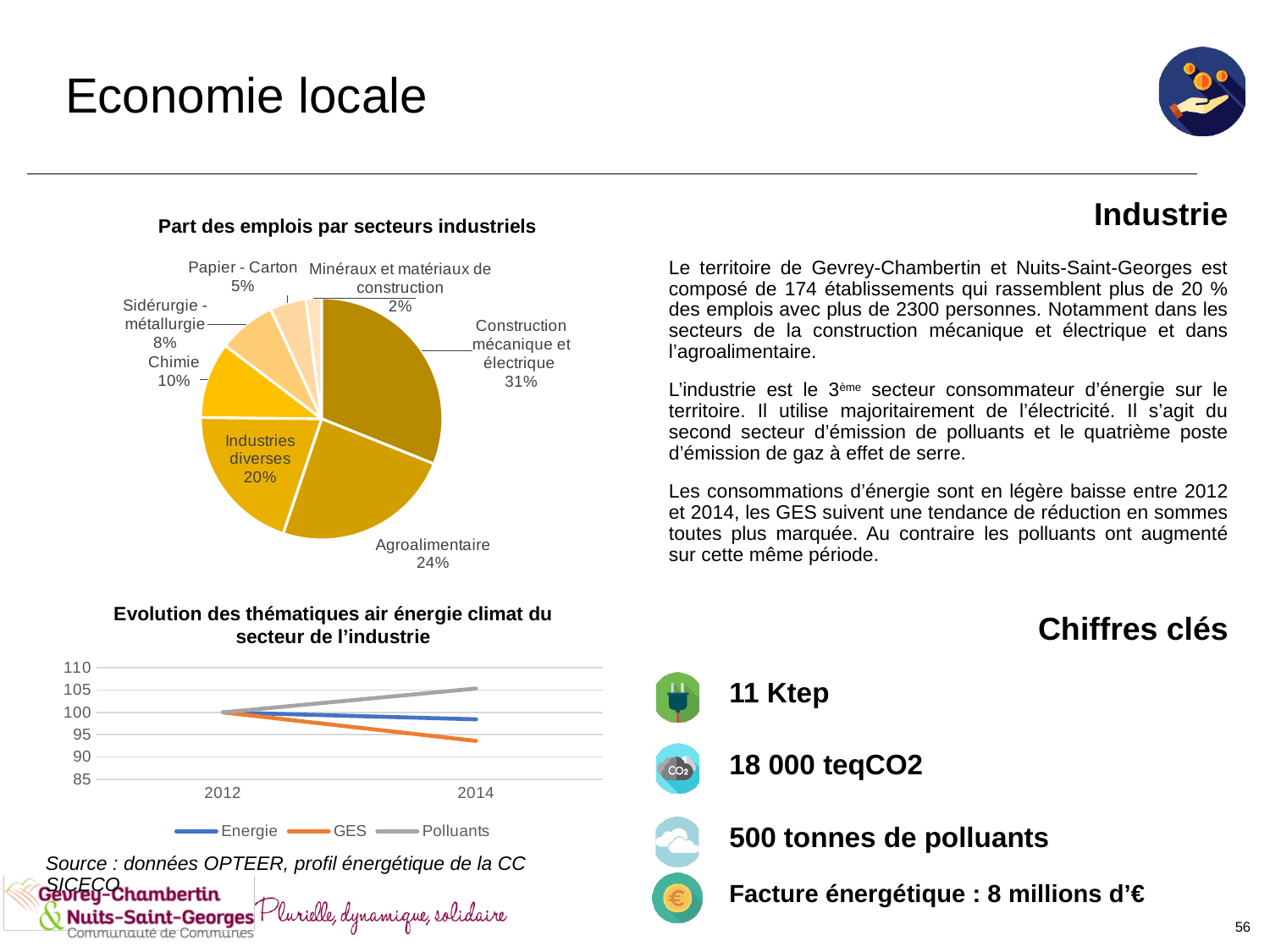
In the pie chart 'Part des emplois par secteurs industriels', which sector has the largest share? Construction mécanique et électrique In the chart 'Evolution des thématiques air énergie climat du secteur de l'industrie', is the value for GES in 2014 greater or less than 100? less In the pie chart 'Part des emplois par secteurs industriels', which sector has the smallest share? Minéraux et matériaux de construction In the pie chart 'Part des emplois par secteurs industriels', which is larger: Sidérurgie - métallurgie or Papier - Carton? Sidérurgie - métallurgie How many sectors are shown in the pie chart 'Part des emplois par secteurs industriels'? 7 What type of chart is 'Evolution des thématiques air énergie climat du secteur de l'industrie'? Line chart In the pie chart 'Part des emplois par secteurs industriels', what is the difference in percentage points between Industries diverses and Chimie? 10 How many series does the legend of the chart 'Evolution des thématiques air énergie climat du secteur de l'industrie' list? 3 In the pie chart 'Part des emplois par secteurs industriels', what is the share for Agroalimentaire? 24% What type of chart is 'Part des emplois par secteurs industriels'? Pie chart In the pie chart 'Part des emplois par secteurs industriels', what share of jobs does Construction mécanique et électrique represent? 31% In the chart 'Evolution des thématiques air énergie climat du secteur de l'industrie', does the Polluants series rise or fall between 2012 and 2014? Rise